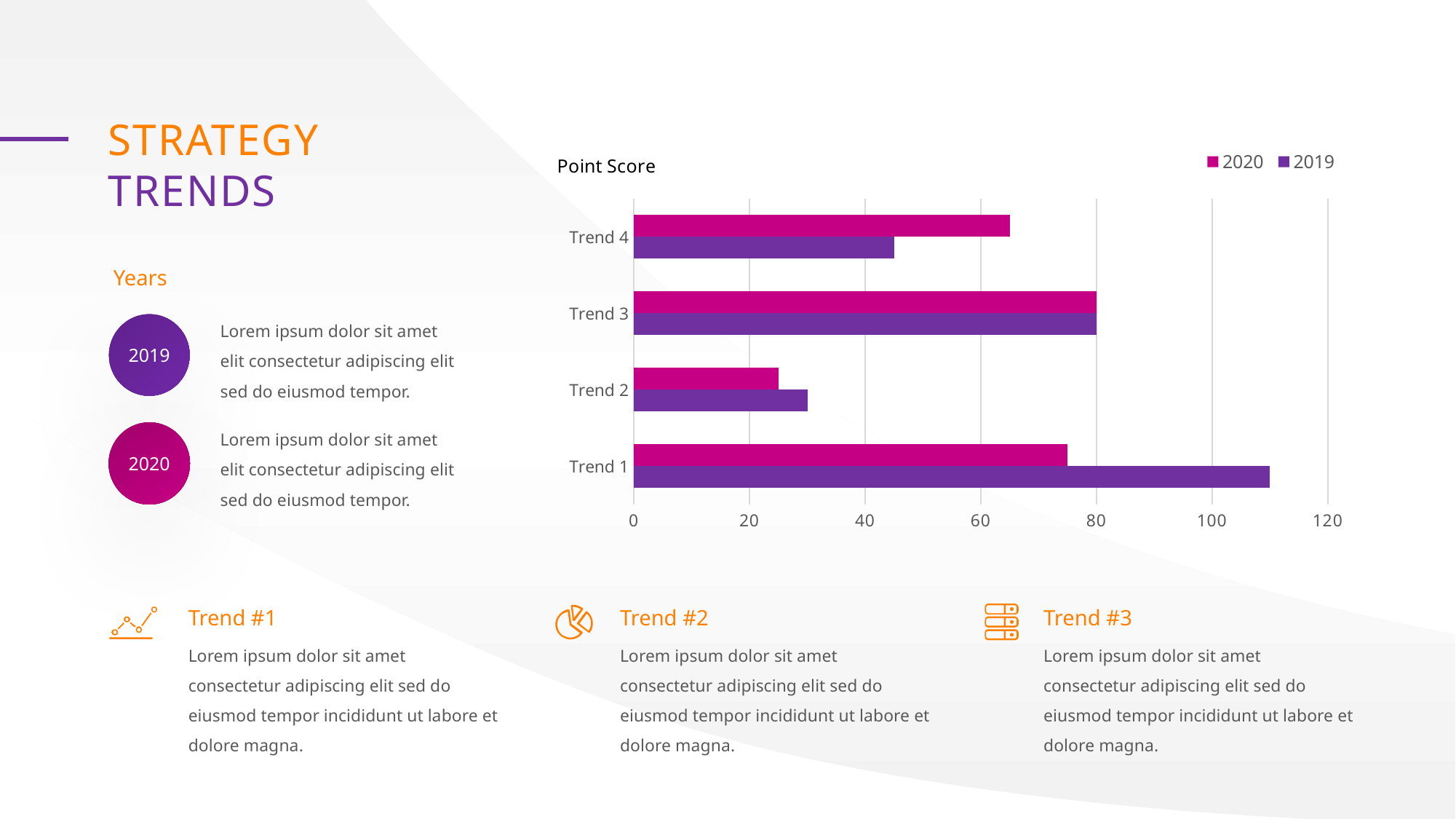
How many series does the chart legend list? 2 Is the 2019 value for Trend 1 greater or less than 100? greater What kind of chart is shown on the slide? bar chart Which trend has the lowest value for 2019? Trend 2 Which trend has the highest value for 2019? Trend 1 For Trend 4, which year has the larger value, 2019 or 2020? 2020 What is the title of the chart? Point Score Which series is shown in purple in the legend? 2019 For Trend 1, which year has the larger value, 2019 or 2020? 2019 How many trend categories are plotted on the chart? 4 Which trend has the lowest value for 2020? Trend 2 Is the 2020 value for Trend 2 greater or less than 40? less